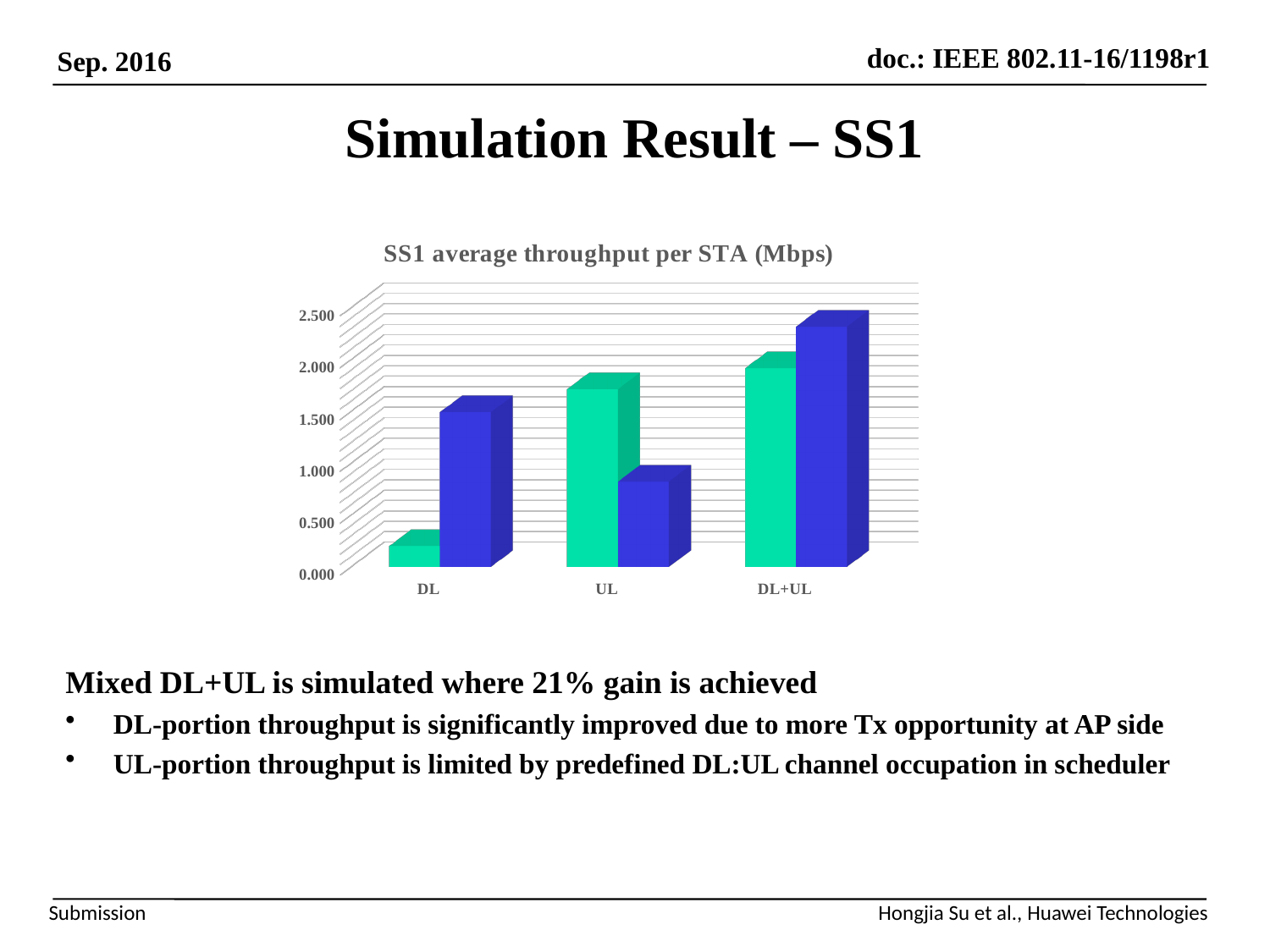
For the UL category, which bar is larger, the green one or the blue one? green How many categories are shown on the x axis of the chart? 3 How many bars are plotted for each category in the chart? 2 What kind of chart is shown on the slide? bar chart Is the value of the green bar for DL greater or less than 0.500? less What is the title of the chart? SS1 average throughput per STA (Mbps) Is the value of the blue bar for DL greater or less than 1.000? greater Which category has the highest blue bar? DL+UL Is the value of the blue bar for UL greater or less than 1.000? less Which category has the lowest green bar? DL